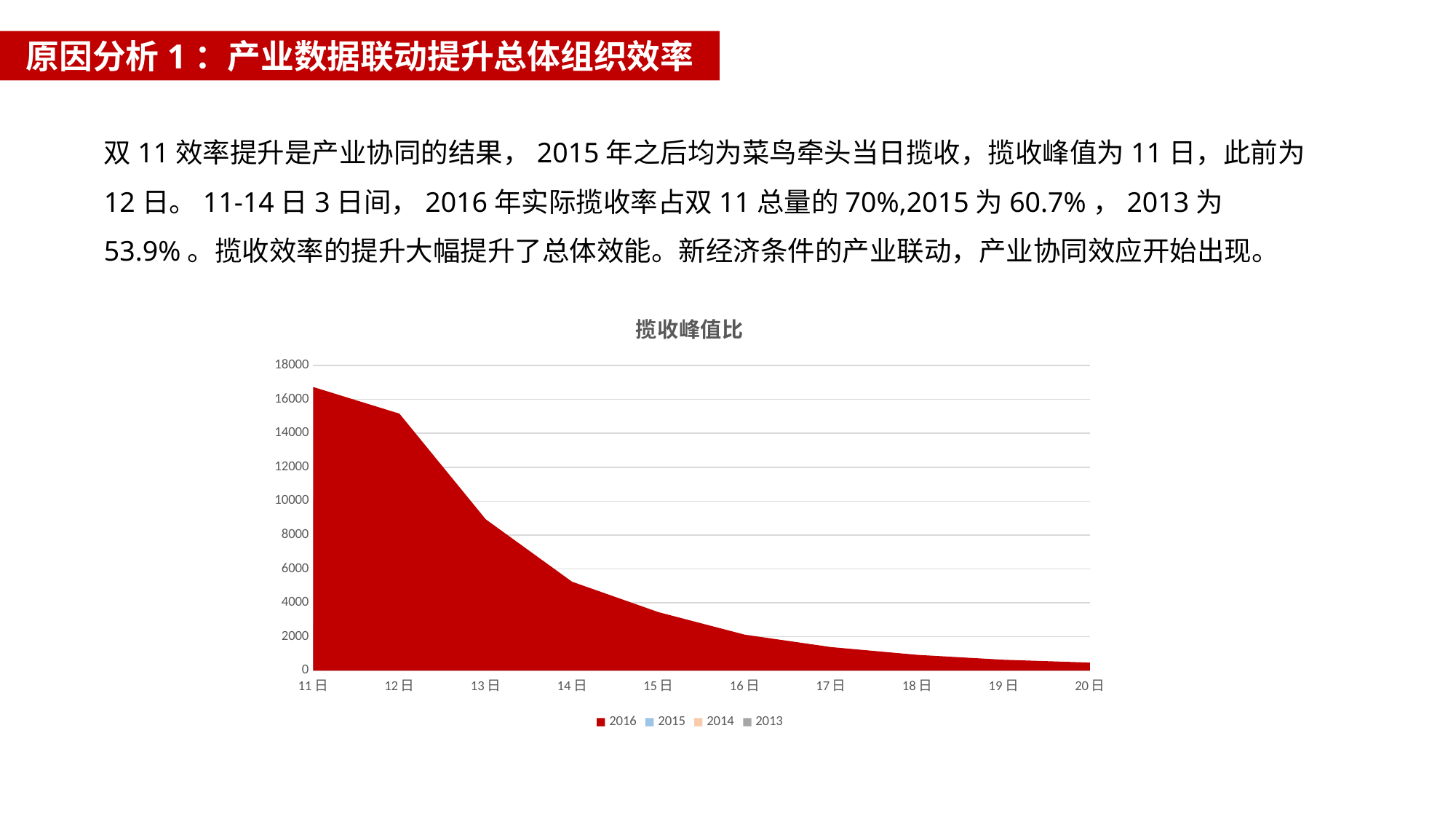
How many series does the legend list? 4 Is the 2016 value for 11 日 greater or less than 16000? greater How many dates are shown along the x axis? 10 What kind of chart is shown on the slide? area chart Is the 2016 value for 14 日 greater or less than 6000? less Which colour represents the 2016 series in the legend? red What is the title of the chart? 揽收峰值比 Which has the larger 2016 value, 12 日 or 13 日? 12 日 Do the 2016 values rise or fall from 11 日 to 20 日? fall Which date has the highest value for 2016? 11 日 Is the 2016 value for 12 日 greater or less than 14000? greater